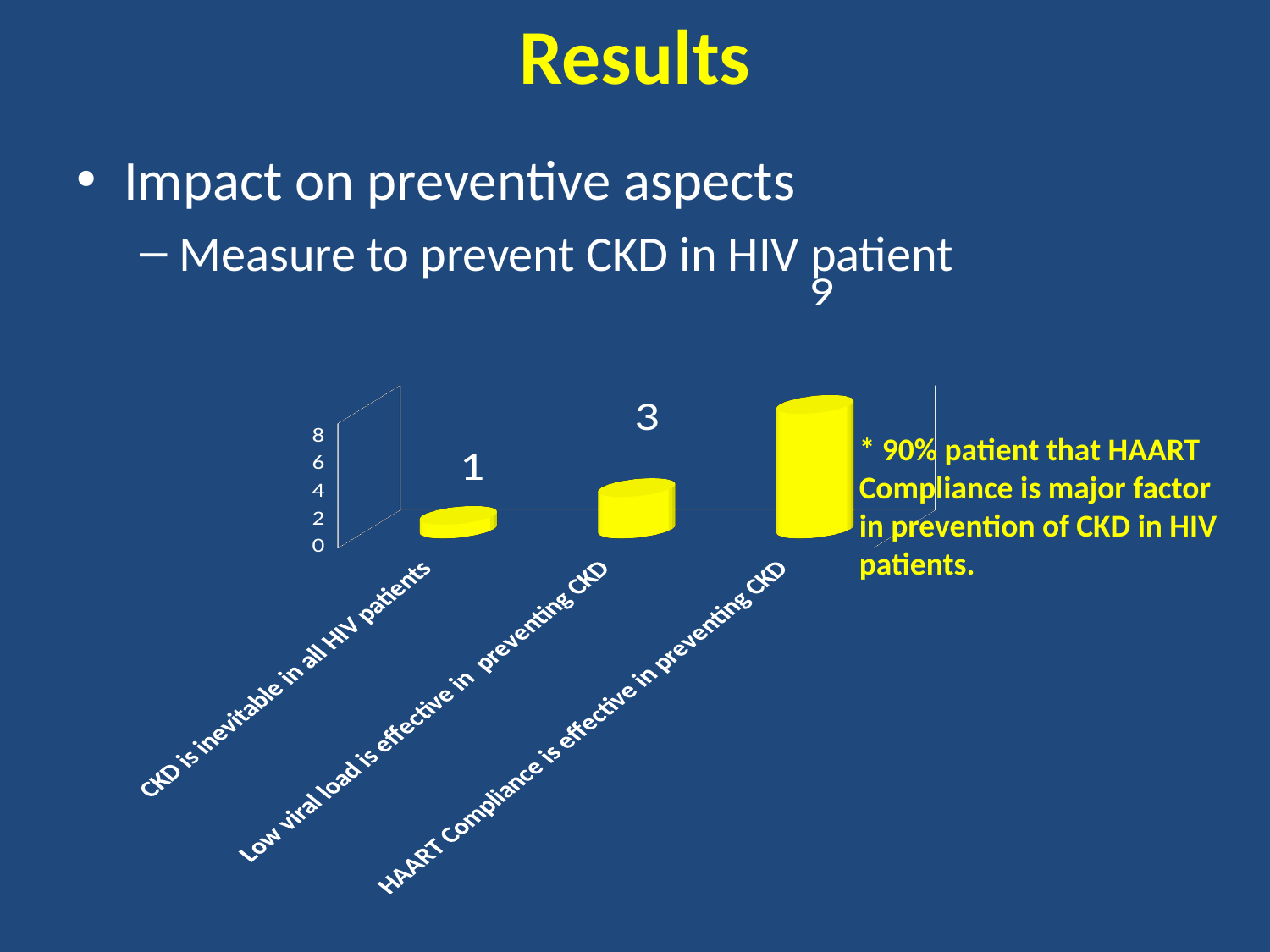
Do the values rise or fall from left to right across the categories? rise What is the value for "HAART Compliance is effective in preventing CKD"? 9 How many categories are shown in the chart? 3 Which is larger: the value for "Low viral load is effective in preventing CKD" or the value for "CKD is inevitable in all HIV patients"? Low viral load is effective in preventing CKD What is the value for "CKD is inevitable in all HIV patients"? 1 Is the value for "HAART Compliance is effective in preventing CKD" greater or less than 8? greater What kind of chart is shown on the slide? bar chart Which category has the lowest value? CKD is inevitable in all HIV patients Which category has the highest value? HAART Compliance is effective in preventing CKD What is the value for "Low viral load is effective in preventing CKD"? 3 What is the difference between the values for "Low viral load is effective in preventing CKD" and "CKD is inevitable in all HIV patients"? 2 What is the difference between the values for "HAART Compliance is effective in preventing CKD" and "Low viral load is effective in preventing CKD"? 6